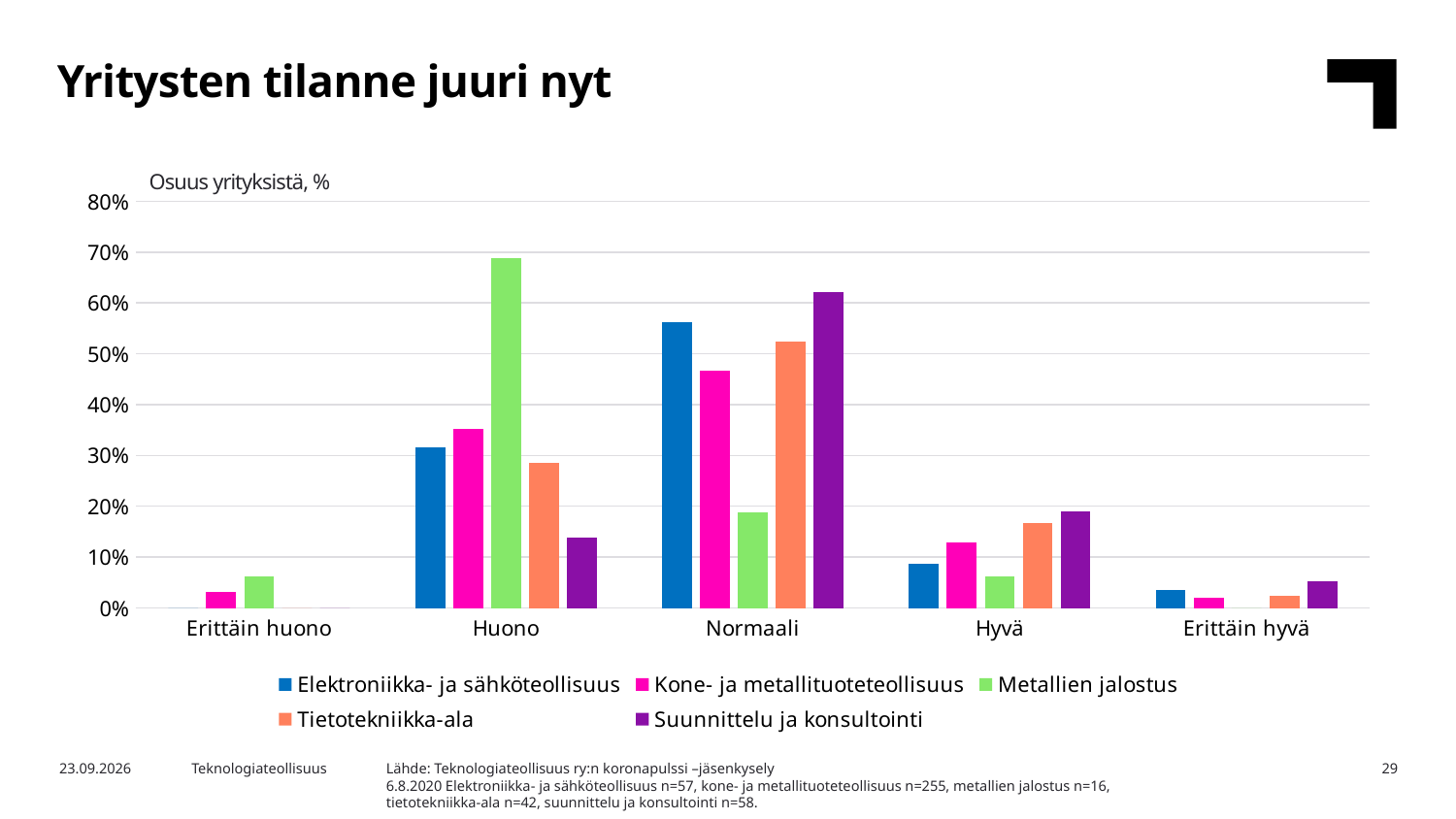
How many series does the legend list? 5 What kind of chart is shown on the slide? bar chart In the Huono category, which is larger: Tietotekniikka-ala or Suunnittelu ja konsultointi? Tietotekniikka-ala Is the value for Metallien jalostus in the Huono category greater or less than 60%? greater For Metallien jalostus, which is larger: the Huono value or the Normaali value? Huono In the Normaali category, which series has the lowest value? Metallien jalostus In the Huono category, which series has the highest value? Metallien jalostus What is the label shown above the y axis of the chart? Osuus yrityksistä, % Is the value for Elektroniikka- ja sähköteollisuus in the Normaali category greater or less than 50%? greater How many categories are shown on the x axis? 5 In the Normaali category, which series has the highest value? Suunnittelu ja konsultointi Is the value for Tietotekniikka-ala in the Hyvä category greater or less than 10%? greater